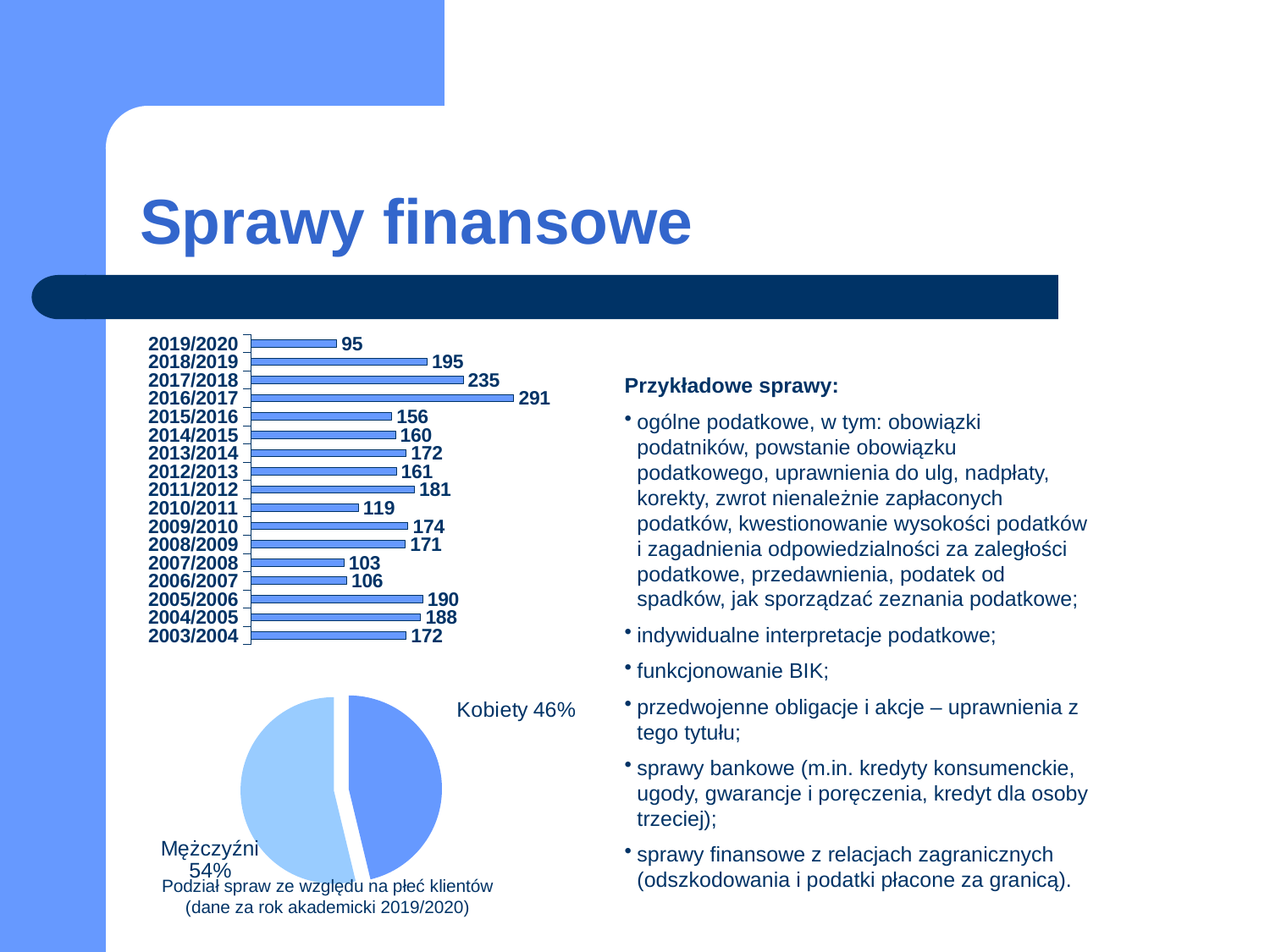
In the bar chart, do the values rise or fall from 2016/2017 to 2019/2020? Fall In the pie chart, what share is labelled Kobiety? 46% What kind of chart is the upper chart on the slide? Bar chart In the bar chart, what is the value for 2010/2011? 119 How many academic years are shown in the bar chart? 17 In the bar chart, which is larger, the value for 2005/2006 or the value for 2004/2005? 2005/2006 In the bar chart, what is the difference between the values for 2017/2018 and 2018/2019? 40 In the bar chart, which academic year has the highest value? 2016/2017 In the pie chart, what share is labelled Mężczyźni? 54% What kind of chart is the lower chart on the slide? Pie chart In the bar chart, what is the value for 2016/2017? 291 In the bar chart, which academic year has the lowest value? 2019/2020